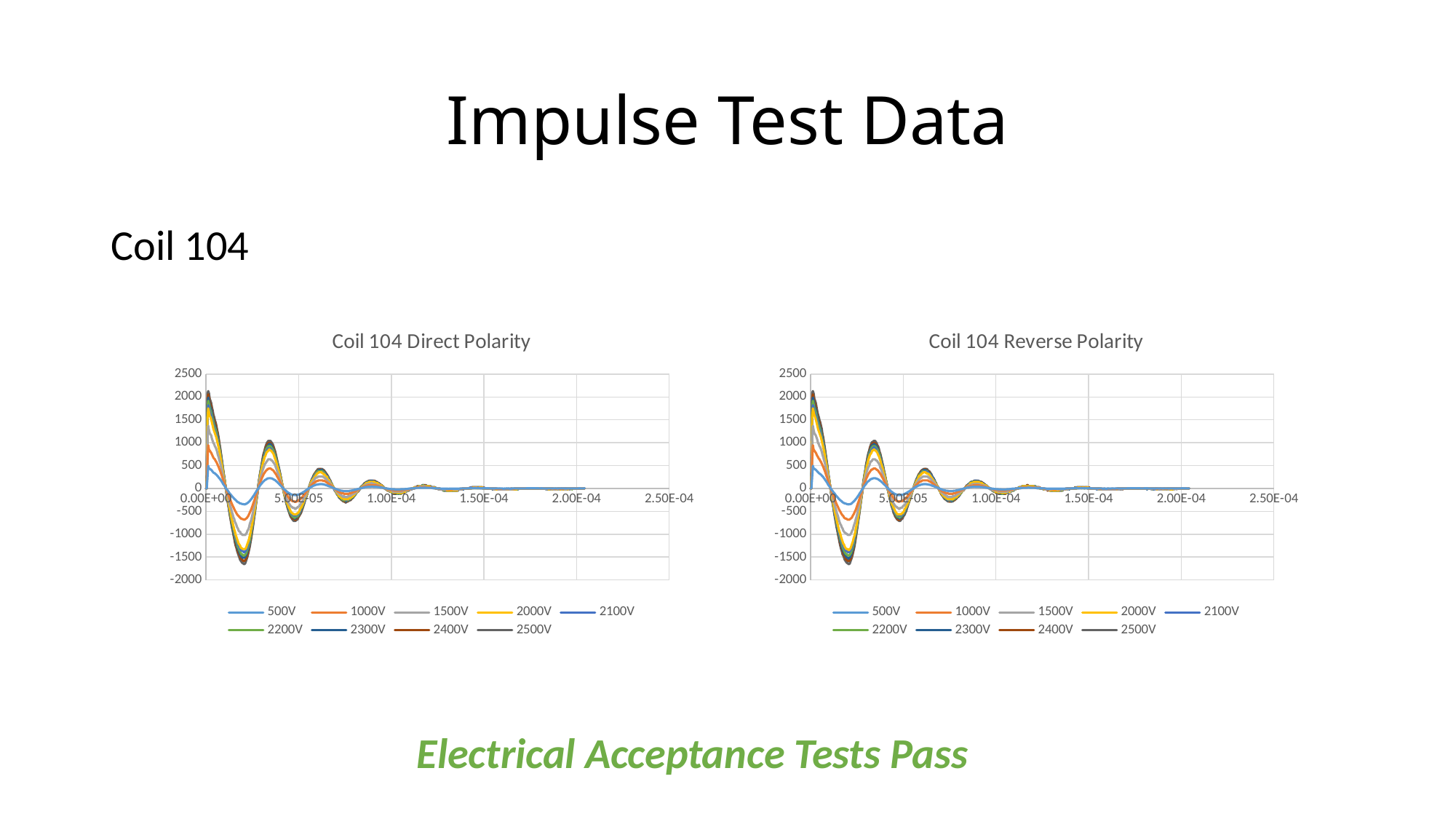
In the Coil 104 Direct Polarity chart, is the first peak of the 500V series greater or less than 1000? less How many series does the legend of the Coil 104 Direct Polarity chart list? 9 In the Coil 104 Direct Polarity chart, which series reaches a higher first peak, 500V or 2500V? 2500V In the Coil 104 Direct Polarity chart, is the first peak of the 2500V series greater or less than 1500? greater What is the title of the chart on the right of the slide? Coil 104 Reverse Polarity How many series does the legend of the Coil 104 Reverse Polarity chart list? 9 In the Coil 104 Reverse Polarity chart, is the lowest value of the 2500V series greater or less than -1000? less What kind of chart is the Coil 104 Reverse Polarity chart? line chart What is the title of the chart on the left of the slide? Coil 104 Direct Polarity What kind of chart is the Coil 104 Direct Polarity chart? line chart In the Coil 104 Direct Polarity chart, does the amplitude of the oscillations increase or decrease as time increases along the x axis? decrease